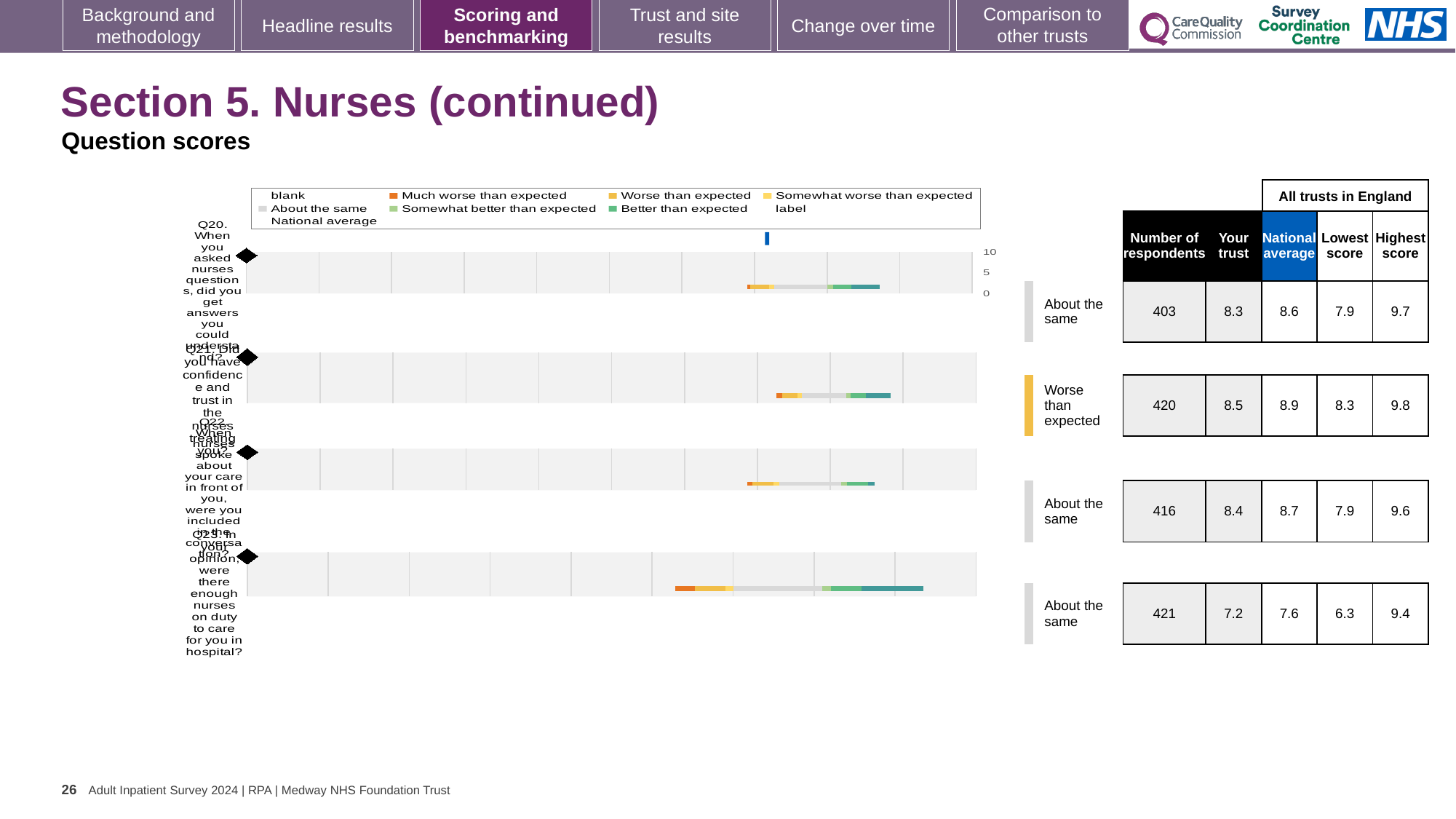
What colour represents 'Much worse than expected' in the legend? orange What benchmark category is shown for Q21? Worse than expected How many respondents answered Q20? 403 Which question has the lowest 'Your trust' score? Q23 What is the national average score for Q23 (were there enough nurses on duty to care for you in hospital?)? 7.6 What is the highest score among all trusts in England for Q22? 9.6 Which question has the highest 'Your trust' score? Q21 What is the 'Your trust' score for Q21 (Did you have confidence and trust in the nurses treating you?)? 8.5 What is the difference between the national average and the 'Your trust' score for Q21? 0.4 How many questions (categories) are plotted in the chart? 4 Which is larger for Q23: the 'Your trust' score or the national average? national average What kind of chart is shown on the slide? bar chart